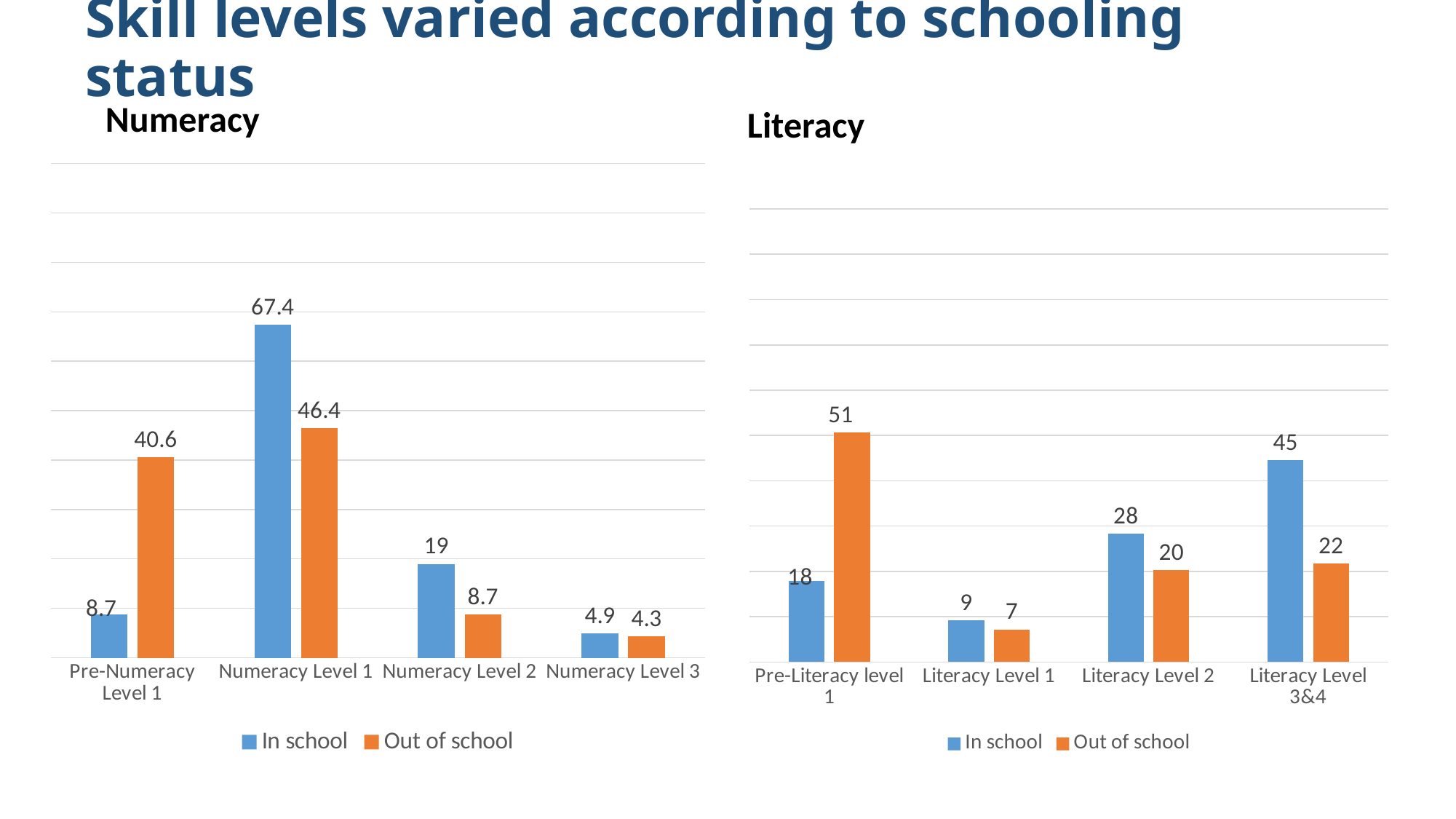
In the Numeracy chart, what is the value for In school at Numeracy Level 1? 67.4 What kind of chart is the Literacy chart? Bar chart In the Numeracy chart, which category has the highest In school value? Numeracy Level 1 How many categories are shown on the x axis of the Numeracy chart? 4 In the Numeracy chart, what is the difference between the In school and Out of school values at Numeracy Level 1? 21 In the Numeracy chart, what is the value for Out of school at Pre-Numeracy Level 1? 40.6 How many series does the legend of the Literacy chart list? 2 In the Literacy chart, what is the value for In school at Literacy Level 3&4? 45 In the Literacy chart, which is larger at Literacy Level 2: In school or Out of school? In school In the Literacy chart, what is the difference between the Out of school and In school values at Pre-Literacy level 1? 33 In the Literacy chart, which category has the lowest Out of school value? Literacy Level 1 In the Literacy chart, what is the value for Out of school at Pre-Literacy level 1? 51